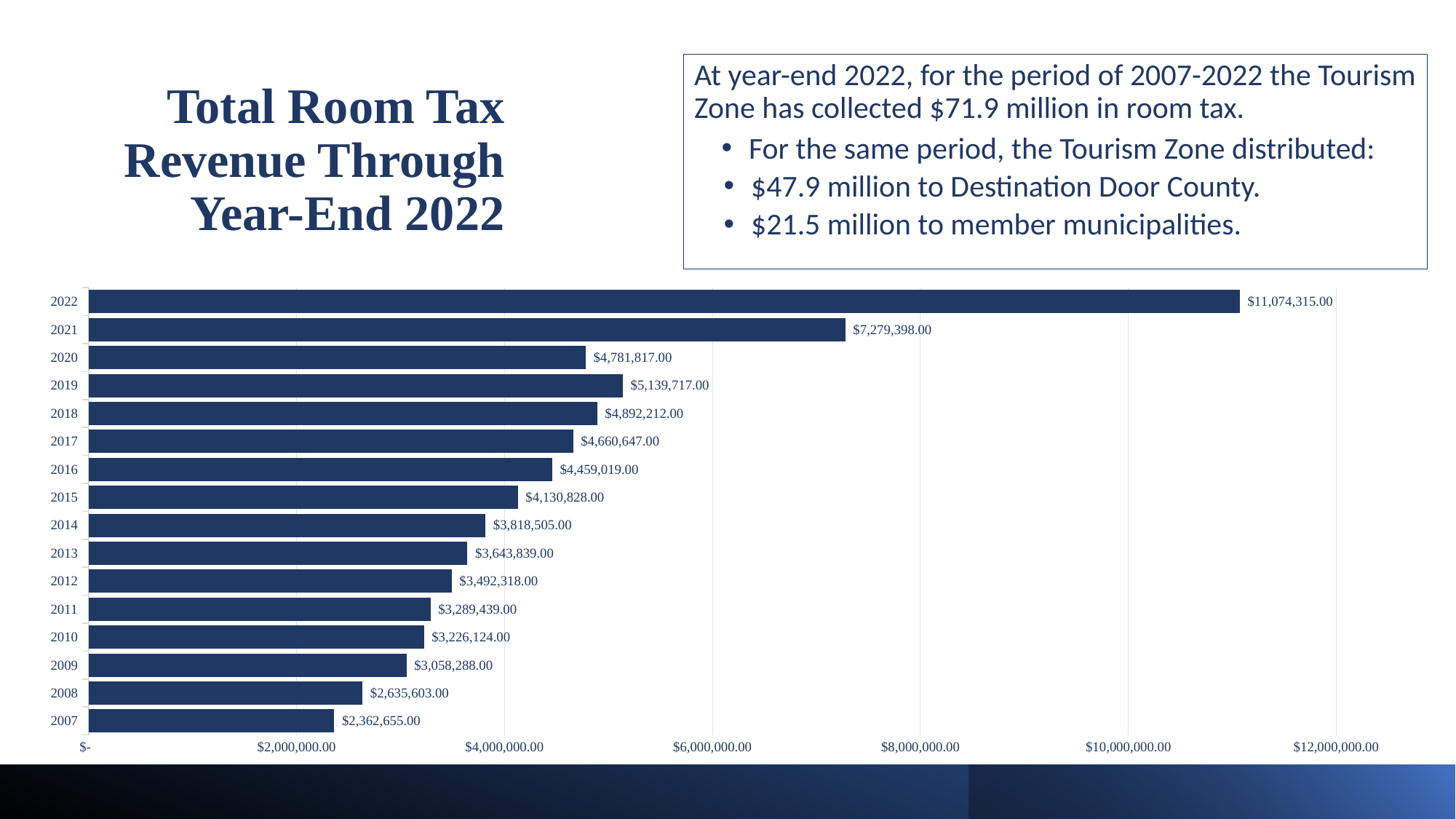
Which year has the lowest room tax revenue in the chart? 2007 What is the difference between the room tax revenue for 2019 and 2020? $357,900.00 What is the total room tax revenue shown for 2007? $2,362,655.00 Which year has the highest room tax revenue in the chart? 2022 What is the difference between the room tax revenue for 2022 and 2021? $3,794,917.00 How many years are shown in the chart? 16 What is the title of the slide containing the chart? Total Room Tax Revenue Through Year-End 2022 What is the total room tax revenue shown for 2015? $4,130,828.00 What is the total room tax revenue shown for 2022? $11,074,315.00 What kind of chart is shown on the slide? bar chart Is the value for 2022 greater or less than $10,000,000.00? greater Which year had higher room tax revenue, 2019 or 2020? 2019